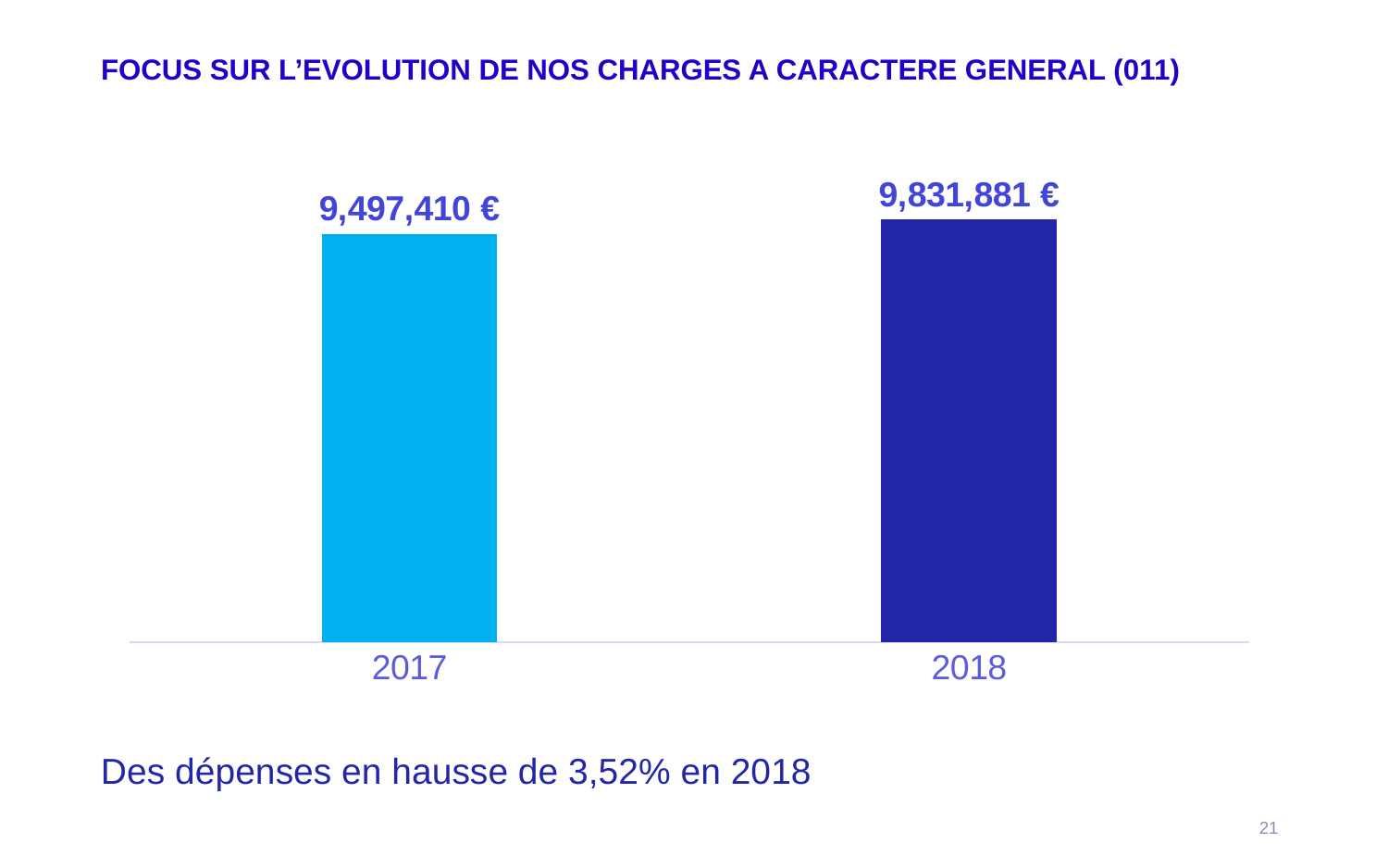
What is the difference between the 2018 and 2017 values? 334,471 € Which year has the highest value? 2018 How many bars are shown in the chart? 2 Which is larger, the value for 2017 or the value for 2018? 2018 Which year has the lowest value? 2017 What kind of chart is shown on the slide? Bar chart What is the combined total of the 2017 and 2018 values? 19,329,291 € What percentage increase in 2018 does the text below the chart state? 3,52% What colour is the bar for 2018? Dark blue Do the values rise or fall from 2017 to 2018? Rise What is the value for 2018? 9,831,881 € What is the value for 2017? 9,497,410 €